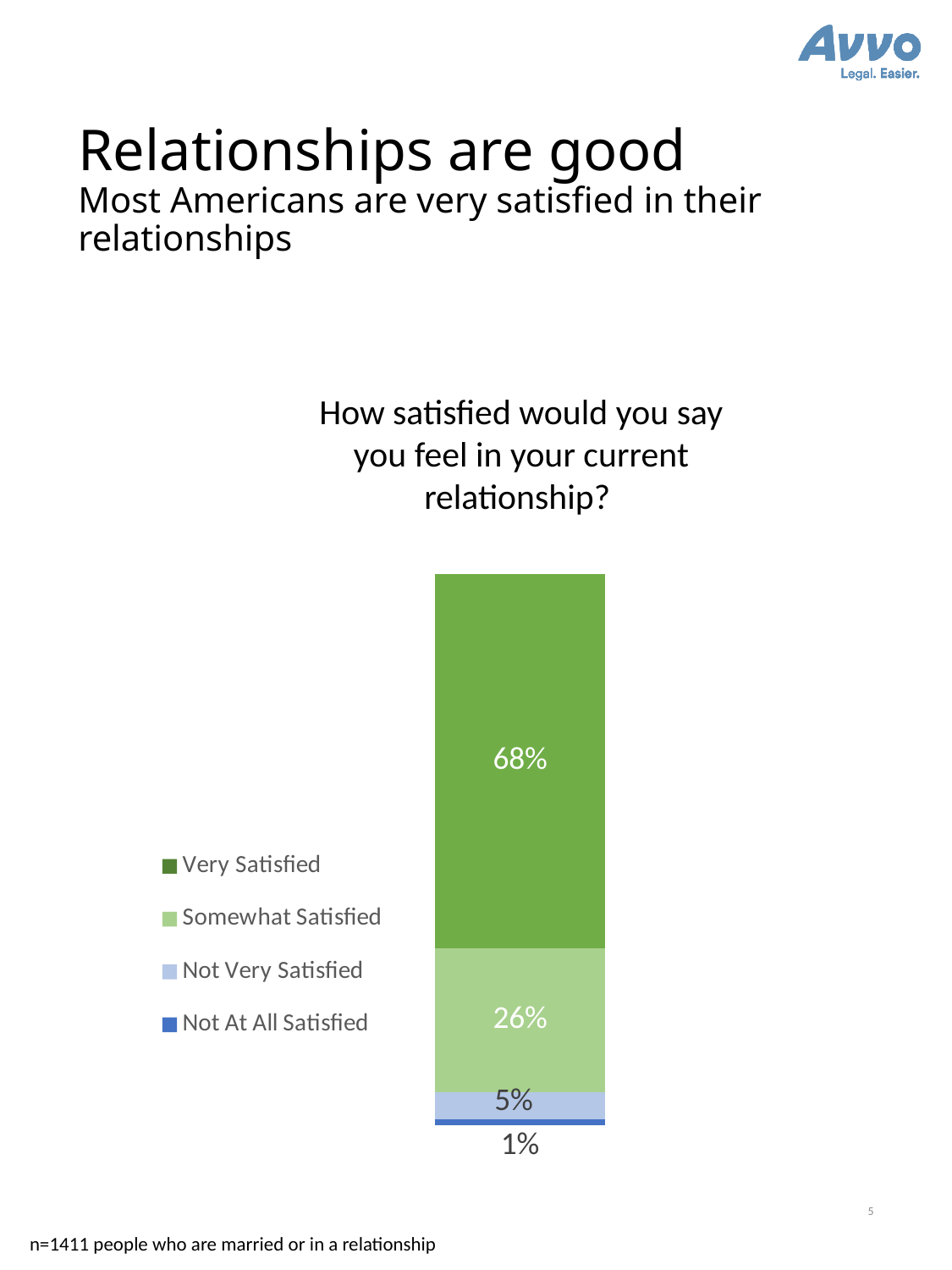
How many series does the legend list? 4 What percentage of respondents are Very Satisfied in their current relationship? 68% Which is larger, the share for Somewhat Satisfied or the share for Not Very Satisfied? Somewhat Satisfied What is the total of all segments in the stacked bar? 100% What is the title of the chart? How satisfied would you say you feel in your current relationship? What percentage of respondents are Not Very Satisfied? 5% What is the difference in percentage points between Very Satisfied and Somewhat Satisfied? 42 What percentage of respondents are Not At All Satisfied? 1% Which satisfaction level has the largest share of respondents? Very Satisfied What kind of chart is shown on the slide? Stacked bar chart Which satisfaction level has the smallest share of respondents? Not At All Satisfied What percentage of respondents are Somewhat Satisfied? 26%